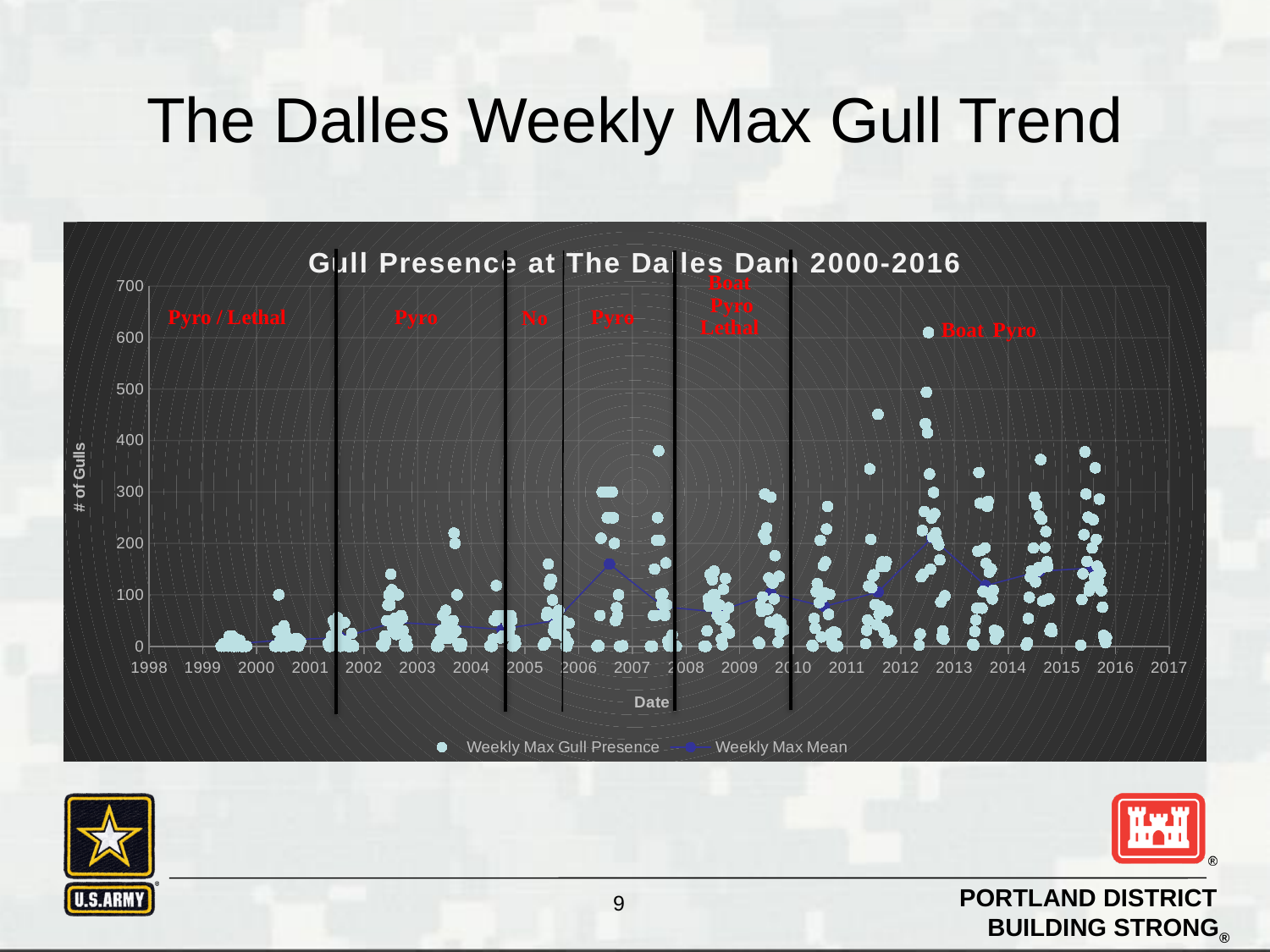
What is the highest value shown on the vertical axis of the chart? 700 What is the title of the chart? Gull Presence at The Dalles Dam 2000-2016 What is the label on the vertical axis of the chart? # of Gulls Is the Weekly Max Mean value around 2006-2007 greater or less than 100? greater Is the Weekly Max Mean value in 2001 greater or less than 100? less How many year labels are shown along the horizontal axis of the chart? 20 Does the Weekly Max Mean line generally rise or fall from 2000 to 2016? rise How many series does the chart legend list? 2 What kind of chart is shown on the slide? Scatter chart Are the Weekly Max Gull Presence points in 1999 greater or less than 100? less